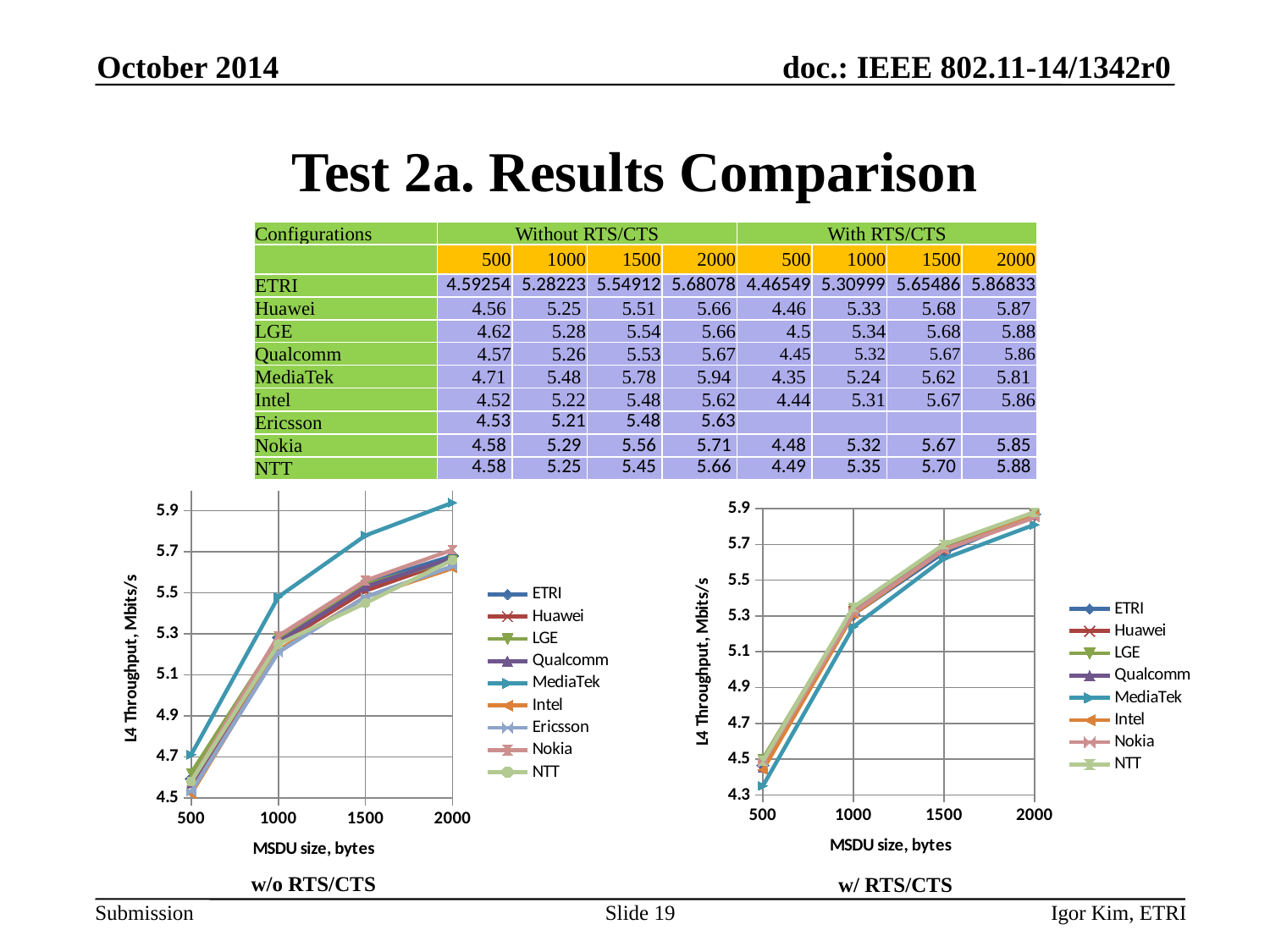
How many series does the legend of the left chart (w/o RTS/CTS) list? 9 In the right chart (w/ RTS/CTS), is the MediaTek value at MSDU size 500 greater or less than 4.5? less What is the y-axis label of the right chart (w/ RTS/CTS)? L4 Throughput, Mbits/s In the left chart (w/o RTS/CTS), do the throughput values rise or fall as MSDU size increases? Rise How many MSDU size points are plotted along the x axis of the right chart (w/ RTS/CTS)? 4 In the left chart (w/o RTS/CTS), which is larger at MSDU size 500: MediaTek or Intel? MediaTek According to the table, what is the MediaTek throughput without RTS/CTS at MSDU size 2000? 5.94 In the left chart (w/o RTS/CTS), which series has the highest throughput at MSDU size 2000? MediaTek In the left chart (w/o RTS/CTS), is the MediaTek value at MSDU size 1500 greater or less than 5.7? greater How many series does the legend of the right chart (w/ RTS/CTS) list? 8 In the right chart (w/ RTS/CTS), which series has the lowest throughput at MSDU size 500? MediaTek What kind of chart is the left chart labelled "w/o RTS/CTS"? Line chart